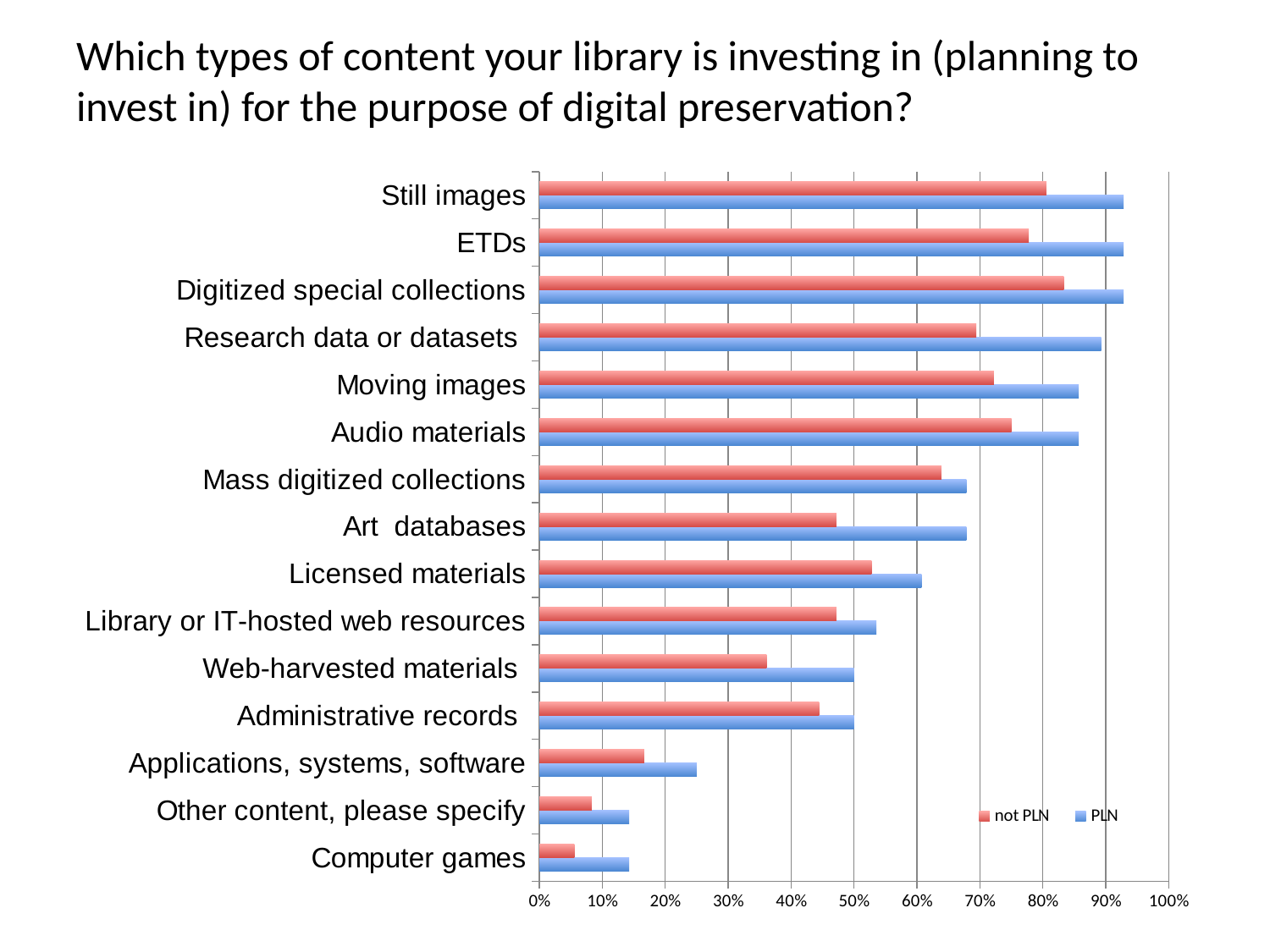
Which category has the lowest value for the not PLN series? Computer games Is the not PLN value for Web-harvested materials greater or less than 40%? less Which category has the highest value for the not PLN series? Digitized special collections Is the PLN value for Applications, systems, software greater or less than 30%? less What kind of chart is shown on the slide? bar chart For the not PLN series, which is larger: Administrative records or Web-harvested materials? Administrative records How many series does the legend list? 2 Is the PLN value for Research data or datasets greater or less than 80%? greater How many content categories are listed on the chart? 15 For Art databases, which series has the larger value, PLN or not PLN? PLN Which two series are shown in the legend? not PLN and PLN